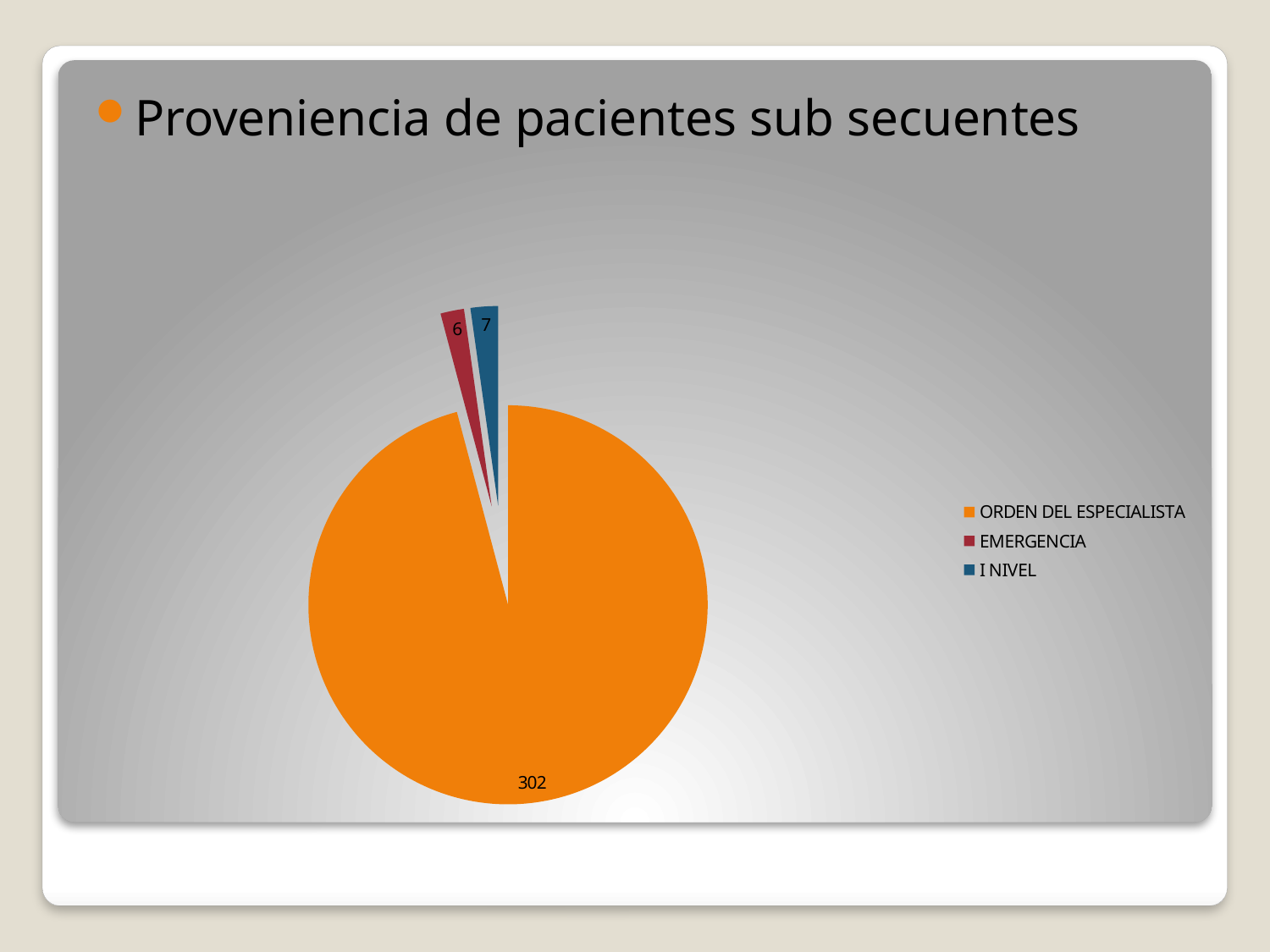
What is the value for ORDEN DEL ESPECIALISTA? 302 Which is larger, the value for I NIVEL or the value for EMERGENCIA? I NIVEL What is the value for I NIVEL? 7 Which category has the largest slice of the pie? ORDEN DEL ESPECIALISTA What is the difference between the values for I NIVEL and EMERGENCIA? 1 What colour is the slice for ORDEN DEL ESPECIALISTA? orange What kind of chart is shown on the slide? pie chart How many categories does the pie chart have? 3 Which category has the smallest slice of the pie? EMERGENCIA What is the total of all slices in the pie chart? 315 What is the difference between the values for ORDEN DEL ESPECIALISTA and I NIVEL? 295 What is the value for EMERGENCIA? 6